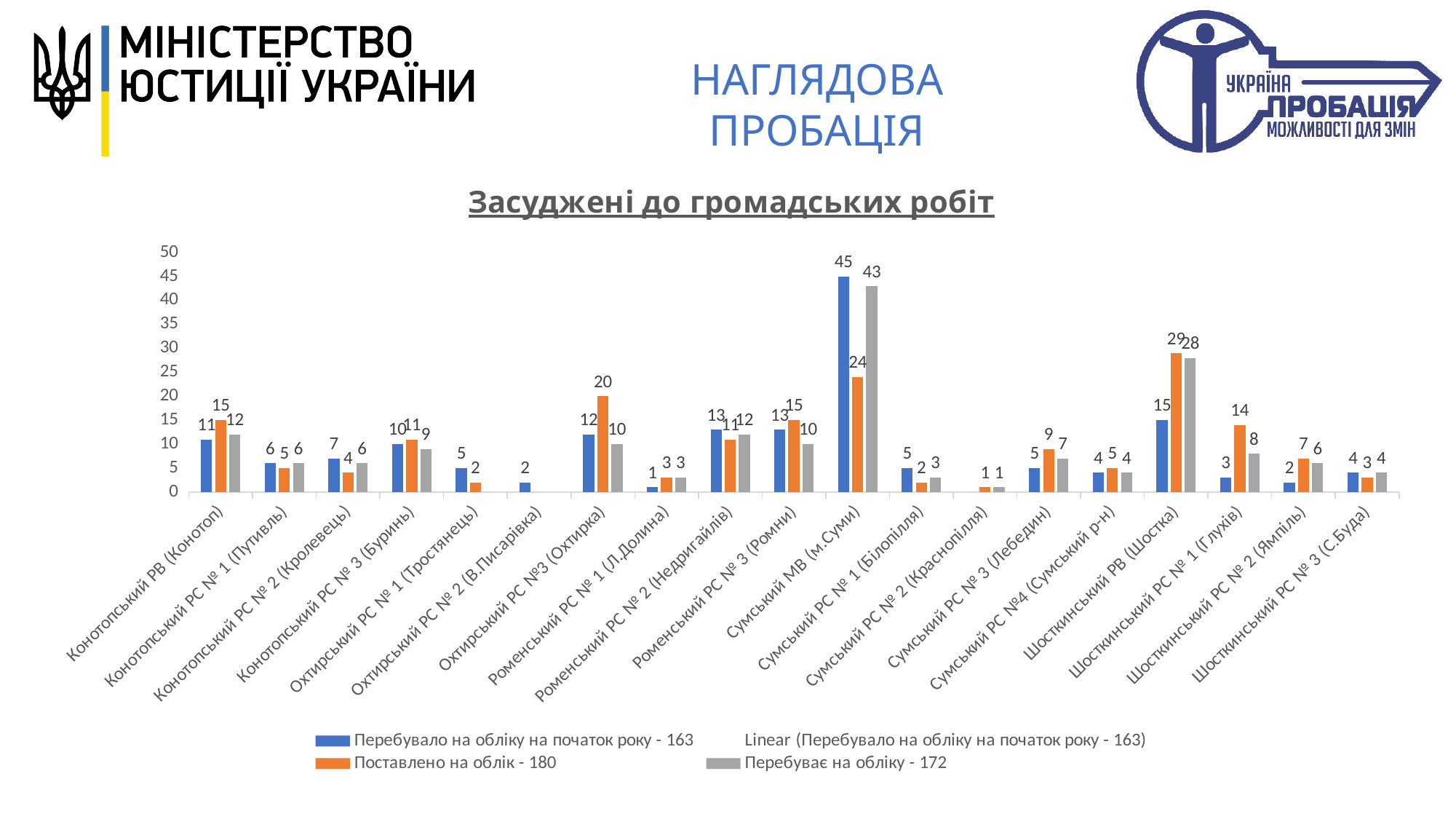
How many categories are shown on the x axis of the chart? 19 What is the value of 'Перебувало на обліку на початок року - 163' for Сумський МВ (м.Суми)? 45 What is the value of 'Перебуває на обліку - 172' for Шосткинський РВ (Шостка)? 28 What is the difference between 'Поставлено на облік - 180' and 'Перебувало на обліку на початок року - 163' for Шосткинський РС № 1 (Глухів)? 11 What colour are the bars for 'Поставлено на облік - 180'? orange What type of chart is shown on the slide? bar chart Which category has the highest value for 'Поставлено на облік - 180'? Шосткинський РВ (Шостка) Is the value of 'Перебуває на обліку - 172' for Сумський МВ (м.Суми) greater or less than 40? greater For Сумський МВ (м.Суми), which is larger: 'Перебувало на обліку на початок року - 163' or 'Поставлено на облік - 180'? Перебувало на обліку на початок року - 163 What is the title of the chart? Засуджені до громадських робіт Which category has the highest value for 'Перебуває на обліку - 172'? Сумський МВ (м.Суми) What is the value of 'Поставлено на облік - 180' for Охтирський РС №3 (Охтирка)? 20